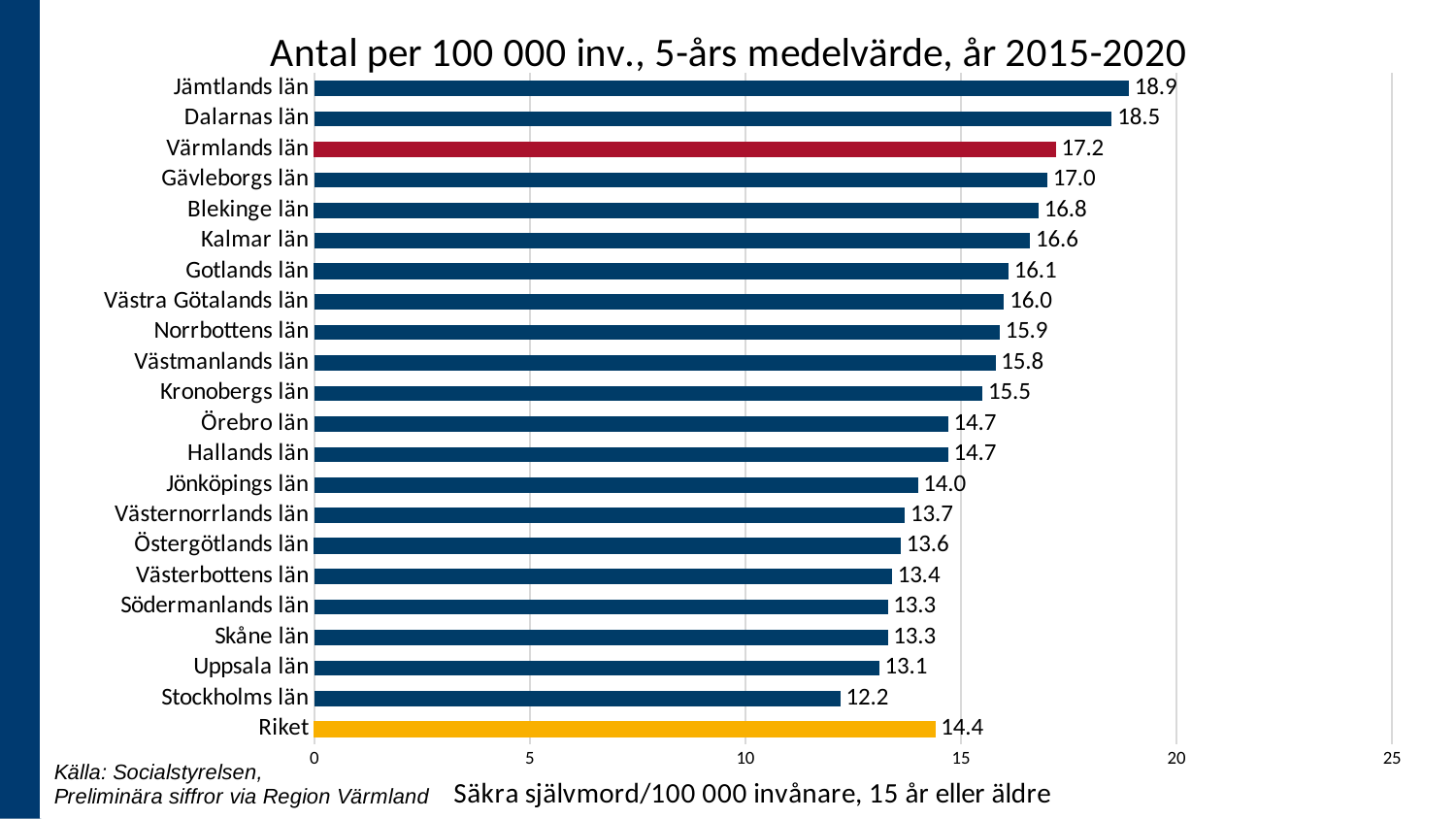
What is the title of the chart? Antal per 100 000 inv., 5-års medelvärde, år 2015-2020 Is the value for Kronobergs län greater or less than 15? greater Which category has the highest value? Jämtlands län What kind of chart is shown on the slide? Bar chart What is the difference between the values for Värmlands län and Riket? 2.8 What is the difference between the values for Jämtlands län and Stockholms län? 6.7 What is the value for Riket? 14.4 How many bars are shown in the chart? 22 Which category has the lowest value? Stockholms län What is the value for Värmlands län? 17.2 What is the value for Stockholms län? 12.2 Which is larger, the value for Dalarnas län or the value for Gävleborgs län? Dalarnas län